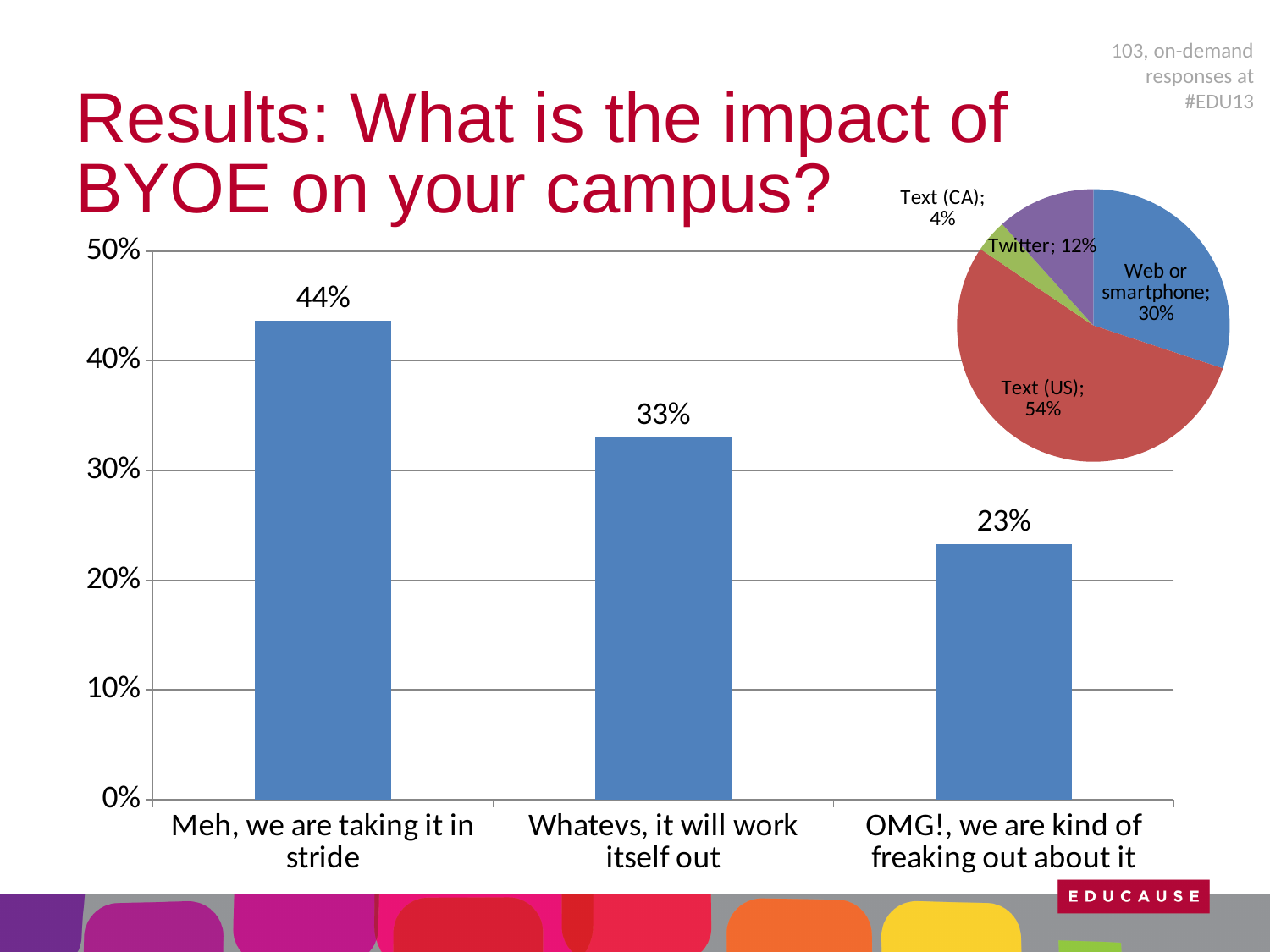
In the pie chart in the top right, how many slices are there? 4 In the pie chart in the top right, which is larger: "Web or smartphone" or "Twitter"? Web or smartphone In the bar chart, what is the value for "Meh, we are taking it in stride"? 44% In the bar chart, which category has the lowest value? OMG!, we are kind of freaking out about it In the bar chart, what is the value for "OMG!, we are kind of freaking out about it"? 23% In the bar chart, do the values rise or fall from left to right? fall What kind of chart is the large chart on the left of the slide? bar chart In the bar chart, how many categories are shown? 3 In the pie chart in the top right, what share does "Text (US)" have? 54% In the pie chart in the top right, which slice is the smallest? Text (CA) In the bar chart, what is the difference between "Meh, we are taking it in stride" and "Whatevs, it will work itself out"? 11% In the bar chart, which category has the highest value? Meh, we are taking it in stride